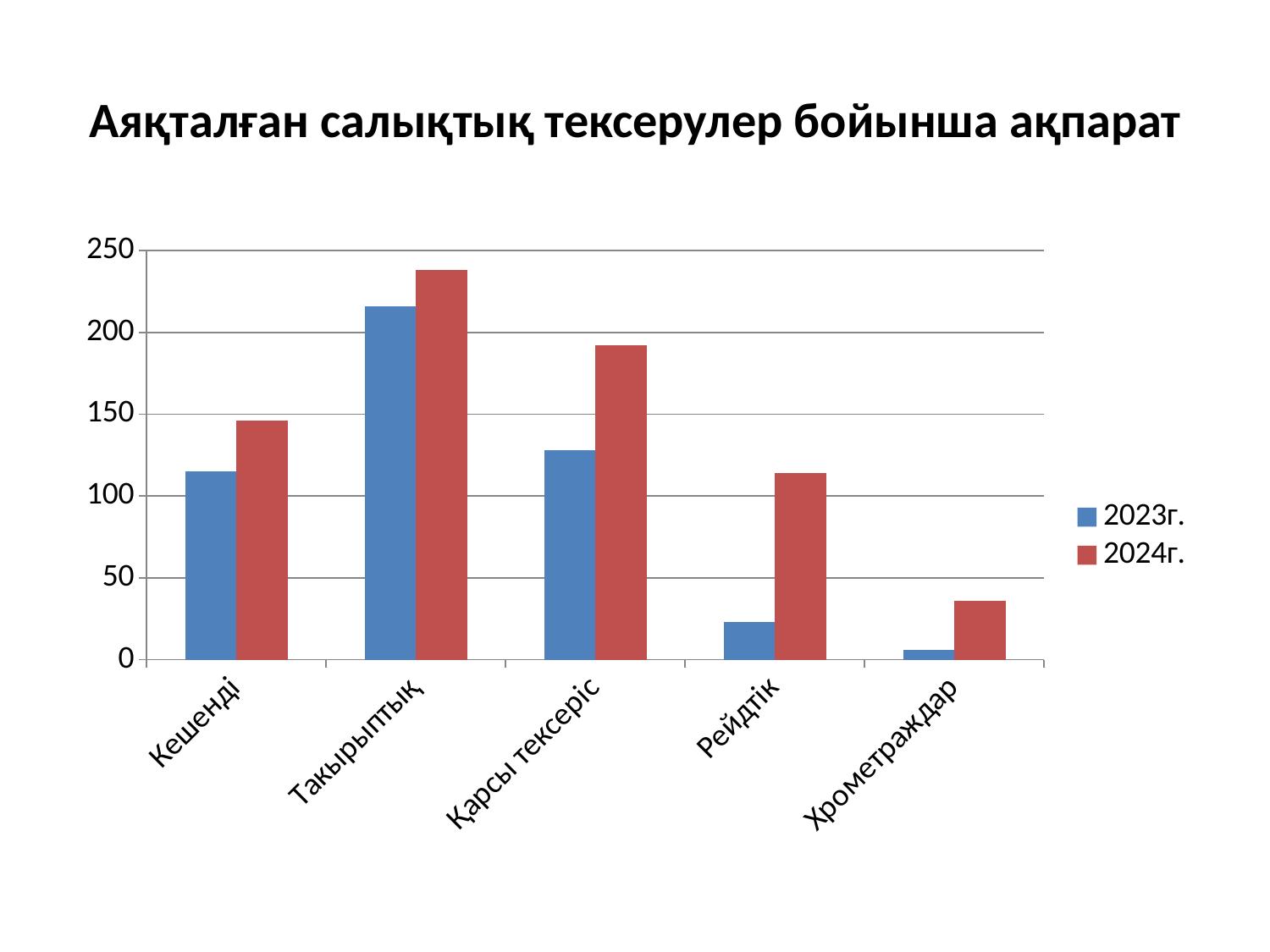
Is the value for Хронометраждар in 2024г. greater or less than 50? less Is the value for Кешенді in 2023г. greater or less than 100? greater What is the title of the chart? Аяқталған салықтық тексерулер бойынша ақпарат Which category has the lowest value for 2023г.? Хрометраждар Which category has the highest value for 2024г.? Такырыптық Which is larger for Қарсы тексеріс: the 2023г. value or the 2024г. value? 2024г. Which series is shown in red? 2024г. What kind of chart is shown on the slide? bar chart How many categories are shown on the x axis? 5 Is the value for Рейдтік in 2023г. greater or less than 50? less How many series does the legend list? 2